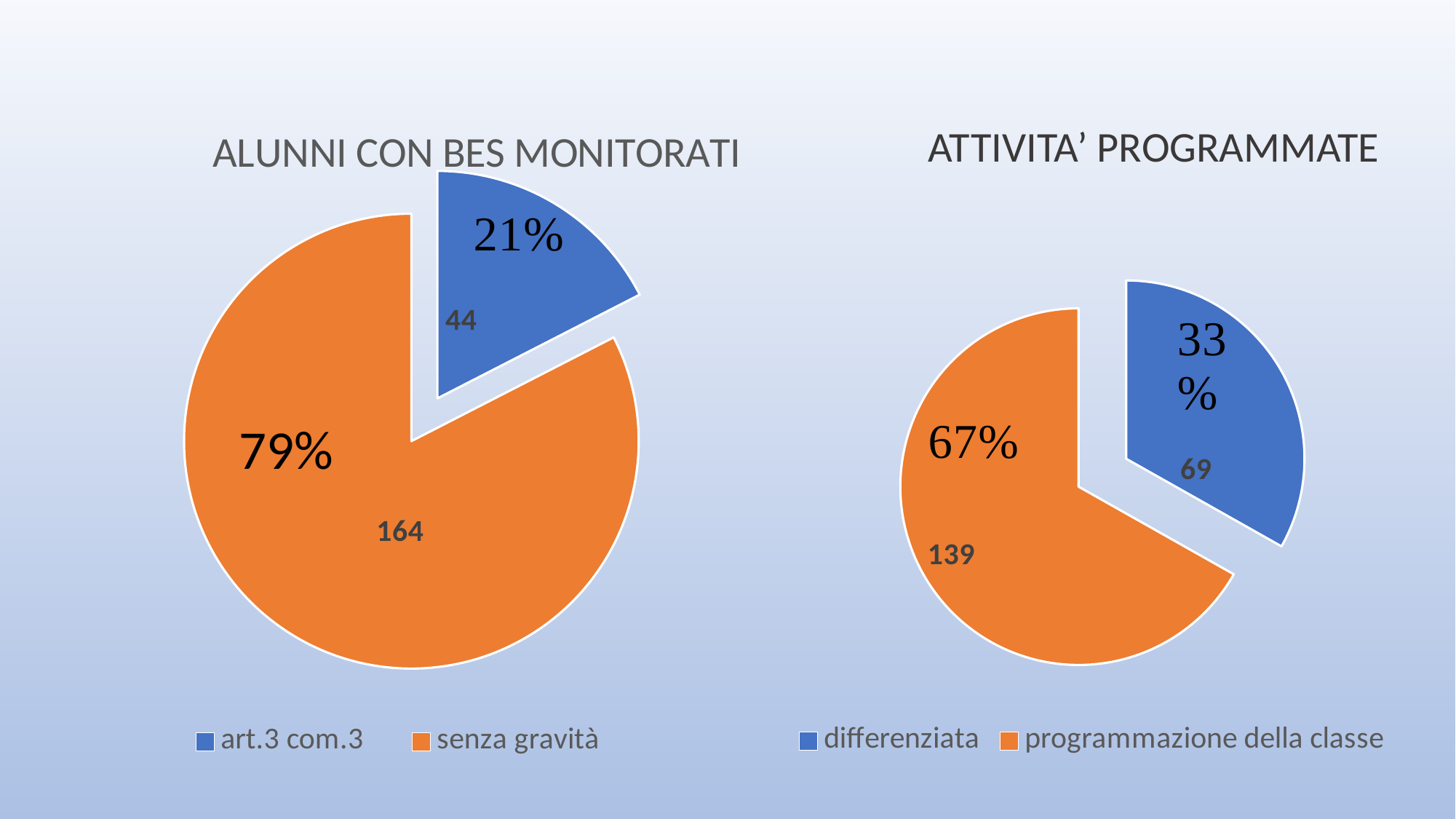
In the 'ALUNNI CON BES MONITORATI' chart, what is the value for 'senza gravità'? 164 In the 'ATTIVITA' PROGRAMMATE' chart, what is the value for 'differenziata'? 69 What type of chart is the 'ATTIVITA' PROGRAMMATE' chart? Pie chart In the 'ATTIVITA' PROGRAMMATE' chart, what is the value for 'programmazione della classe'? 139 In the 'ALUNNI CON BES MONITORATI' chart, what percentage share does 'art.3 com.3' have? 21% In the 'ATTIVITA' PROGRAMMATE' chart, which category is the smallest? differenziata In the 'ATTIVITA' PROGRAMMATE' chart, what is the total of the two slices? 208 In the 'ALUNNI CON BES MONITORATI' chart, what is the value for 'art.3 com.3'? 44 In the 'ALUNNI CON BES MONITORATI' chart, which category is the largest? senza gravità In the 'ATTIVITA' PROGRAMMATE' chart, what percentage share does 'programmazione della classe' have? 67% In the 'ALUNNI CON BES MONITORATI' chart, what is the difference between 'senza gravità' and 'art.3 com.3'? 120 In the 'ALUNNI CON BES MONITORATI' chart, what percentage share does 'senza gravità' have? 79%